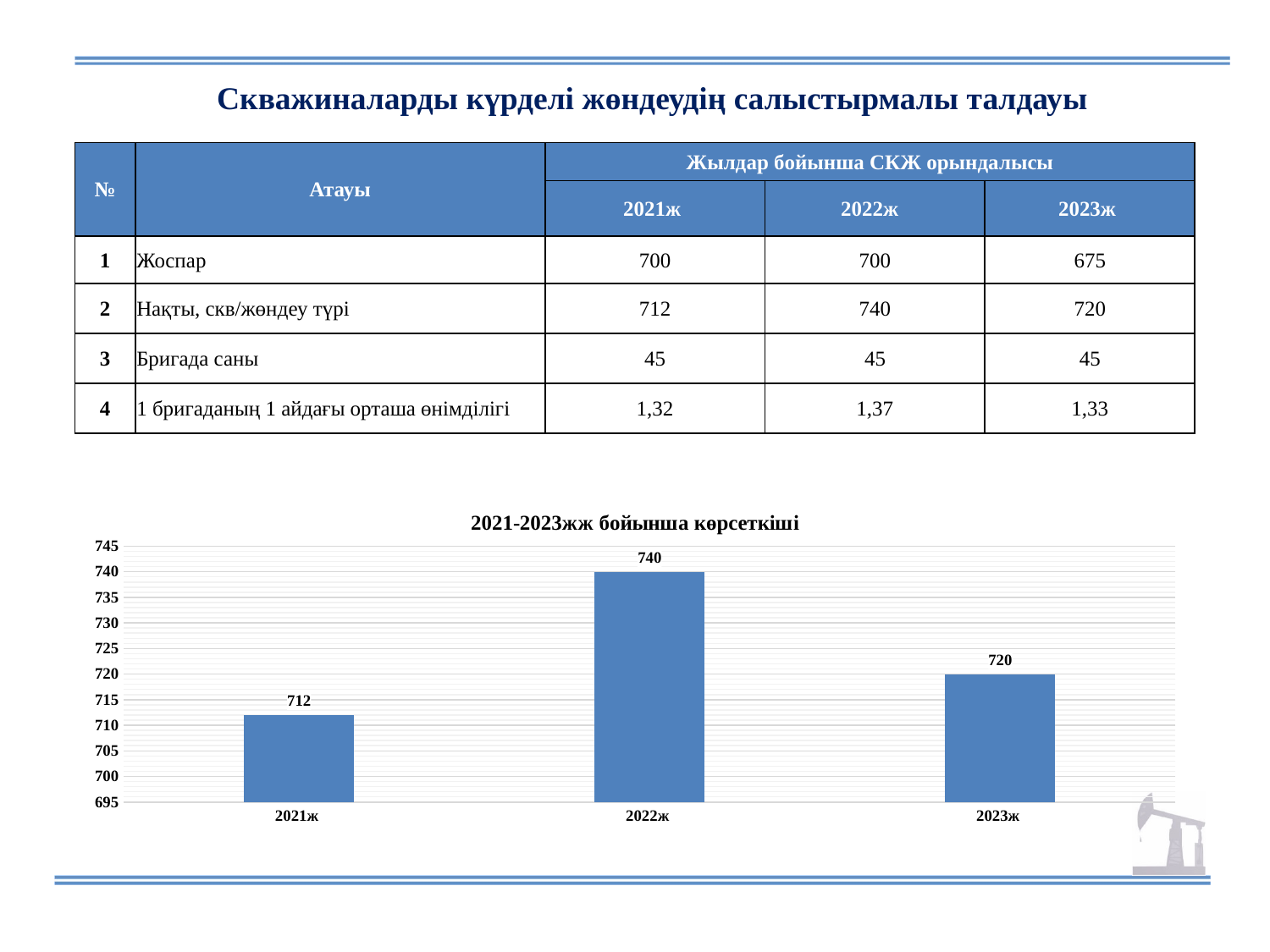
What is the value for 2022ж in the chart? 740 What is the difference between the values for 2022ж and 2021ж? 28 Which year has the lowest value in the chart? 2021ж What kind of chart is shown on the slide? bar chart What is the value for 2021ж in the chart? 712 Is the value for 2022ж greater or less than 735? greater Which year has the highest value in the chart? 2022ж What is the difference between the values for 2022ж and 2023ж? 20 Which is larger, the value for 2023ж or the value for 2021ж? 2023ж How many years are shown on the x axis of the chart? 3 What is the value for 2023ж in the chart? 720 What is the title of the chart? 2021-2023жж бойынша көрсеткіші